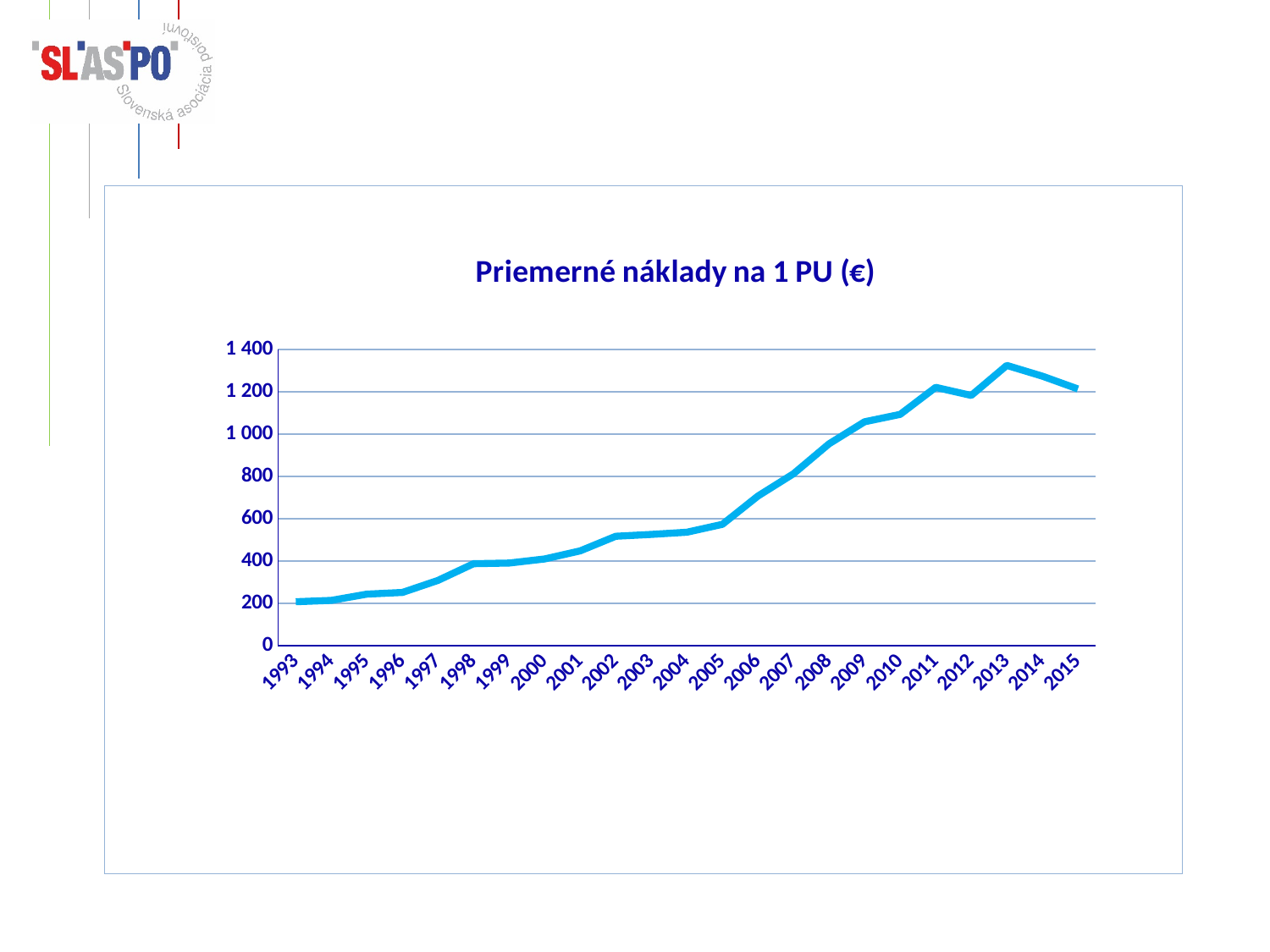
Is the value for 2005 greater or less than 600? less What is the title of the chart? Priemerné náklady na 1 PU (€) How many years are plotted on the x axis of the chart? 23 Which is larger, the value for 2011 or the value for 2012? 2011 Is the value for 2009 greater or less than 1 000? greater Is the value for 2006 greater or less than 600? greater What kind of chart is shown on the slide? line chart Do the values generally rise or fall from 1993 to 2015? rise Which year has the highest value in the chart? 2013 Which is larger, the value for 2013 or the value for 2015? 2013